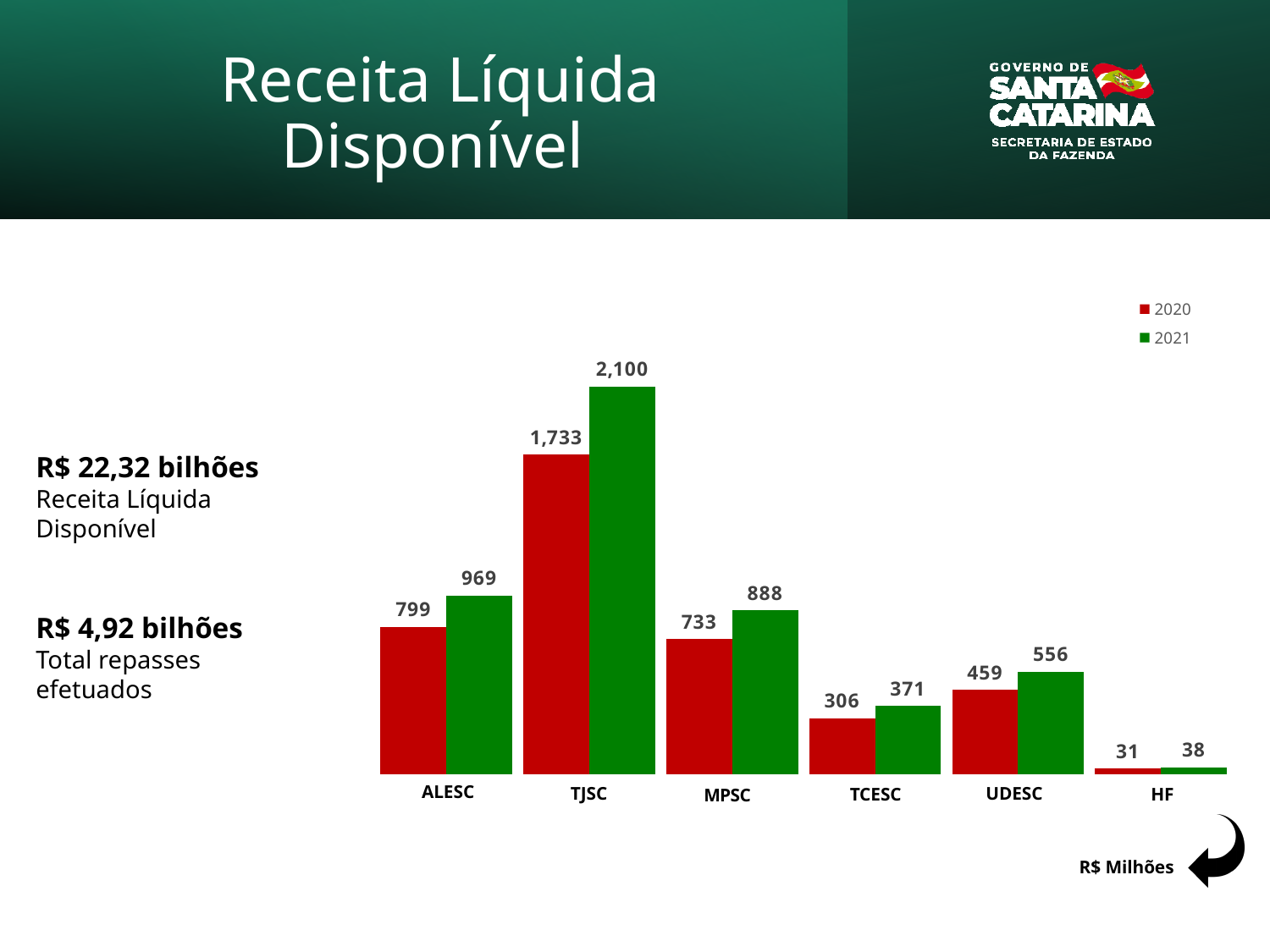
How many categories are shown on the x axis? 6 What is the 2021 value for TJSC? 2,100 What is the difference between the 2021 and 2020 values for TJSC? 367 What kind of chart is shown on the slide? bar chart What is the 2020 value for MPSC? 733 What is the 2021 value for UDESC? 556 What is the difference between the 2021 and 2020 values for ALESC? 170 Which category has the lowest 2021 value? HF Which colour represents the 2021 series in the legend? green How many series does the legend list? 2 Which category has the highest 2020 value? TJSC Which is larger: the 2021 value for MPSC or the 2021 value for ALESC? ALESC